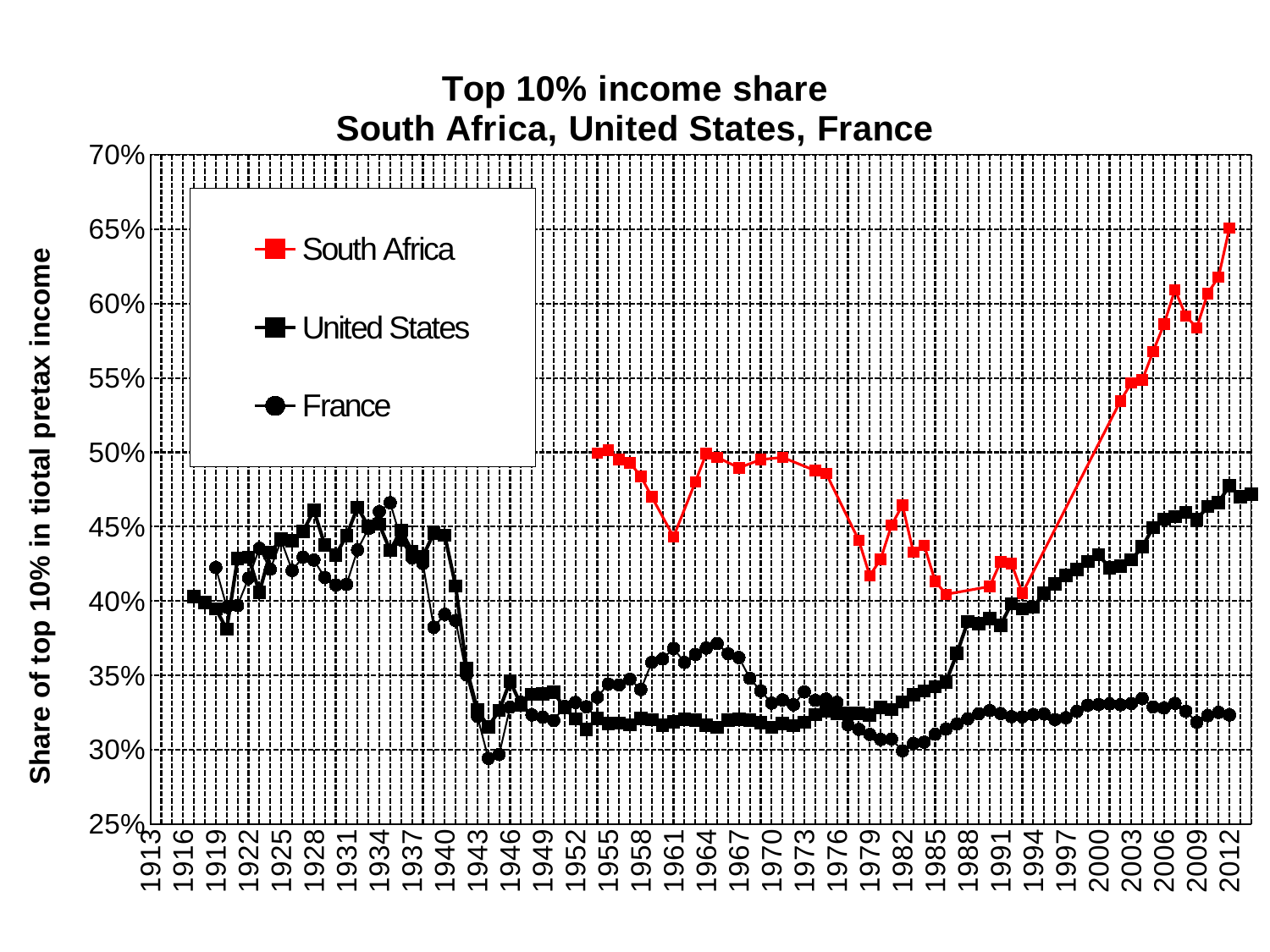
What is the title of the chart? Top 10% income share South Africa, United States, France Which series has the lowest value in 2012? France In 2012, which is larger, the value for the United States or the value for France? United States Which series has the highest value in 2012? South Africa Does the South Africa series rise or fall between 1994 and 2012? rise Which series is drawn in red? South Africa Is the value for South Africa in 1985 greater or less than 45%? less How many series does the legend list? 3 Is the value for South Africa in 2012 greater or less than 60%? greater Is the value for France in 2012 greater or less than 35%? less What kind of chart is shown on the slide? Line chart